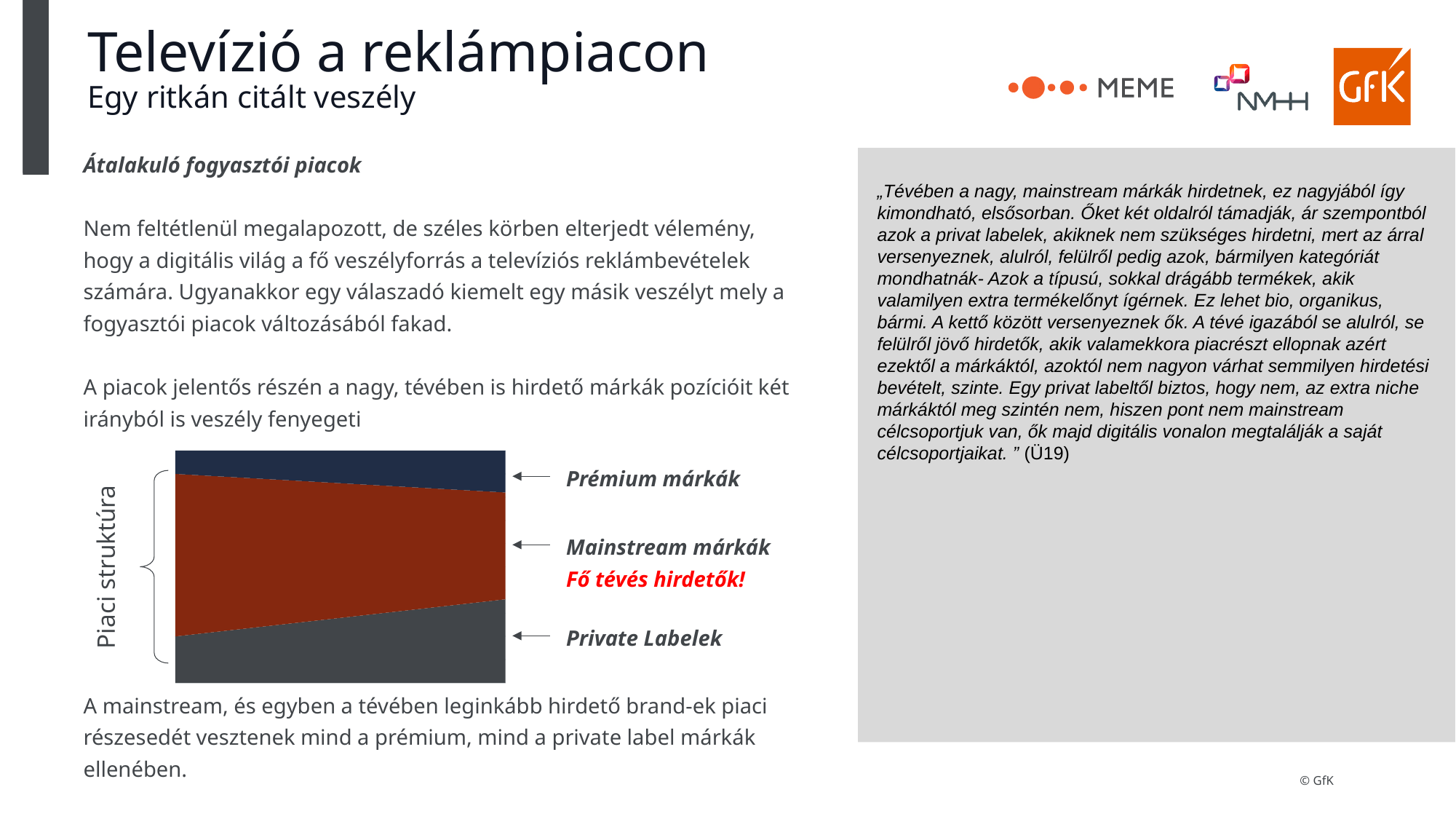
Which segment is shown in the middle of the market structure diagram? Mainstream márkák What label is written along the vertical axis of the market structure diagram? Piaci struktúra Which segment is labelled in red as 'Fő tévés hirdetők!' in the diagram? Mainstream márkák Does the Mainstream márkák band get wider or narrower from left to right in the diagram? narrower Does the Private Labelek band get wider or narrower from left to right in the diagram? wider How many market segments does the market structure diagram show? 3 Does the Prémium márkák band grow or shrink from left to right in the diagram? grow